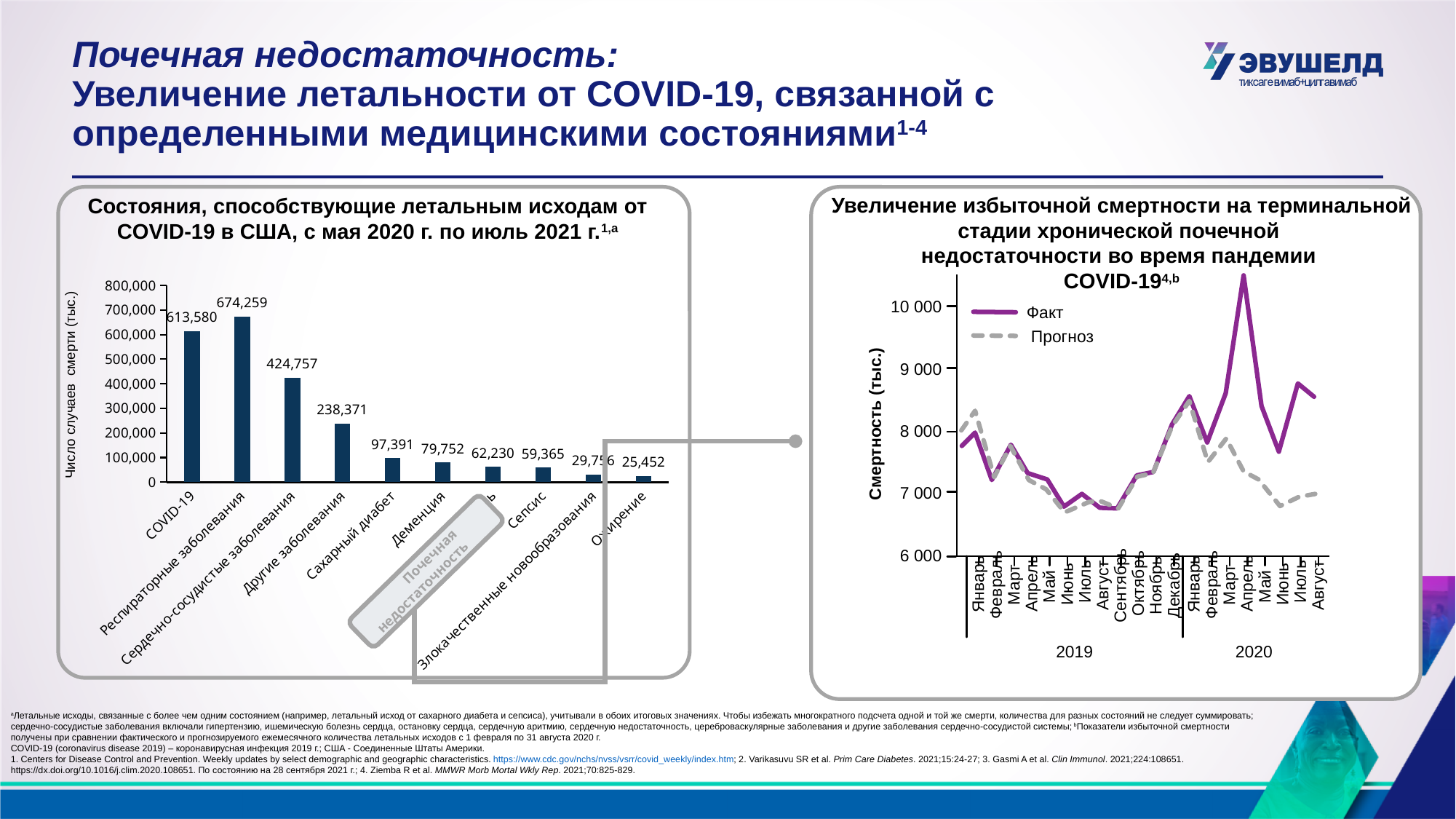
In the right chart, is the value of Прогноз for Июнь 2020 greater or less than 7 000? less How many categories are shown in the left bar chart? 10 In the left chart, which is larger: the value for Деменция or the value for Сепсис? Деменция In the left chart, what is the value for Почечная недостаточность? 62,230 How many series does the legend of the right chart (Увеличение избыточной смертности) list? 2 In the left chart, which category has the highest number of deaths? Респираторные заболевания In the left chart, what is the value for Сахарный диабет? 97,391 What type of chart is the left chart on the slide? Bar chart In the left chart, what is the difference between the values for Респираторные заболевания and COVID-19? 60,679 In the left chart, which category has the lowest number of deaths? Ожирение In the right chart, is the value of Факт for Апрель 2020 greater or less than 10 000? greater In the left chart (Состояния, способствующие летальным исходам от COVID-19 в США), what is the value for Респираторные заболевания? 674,259